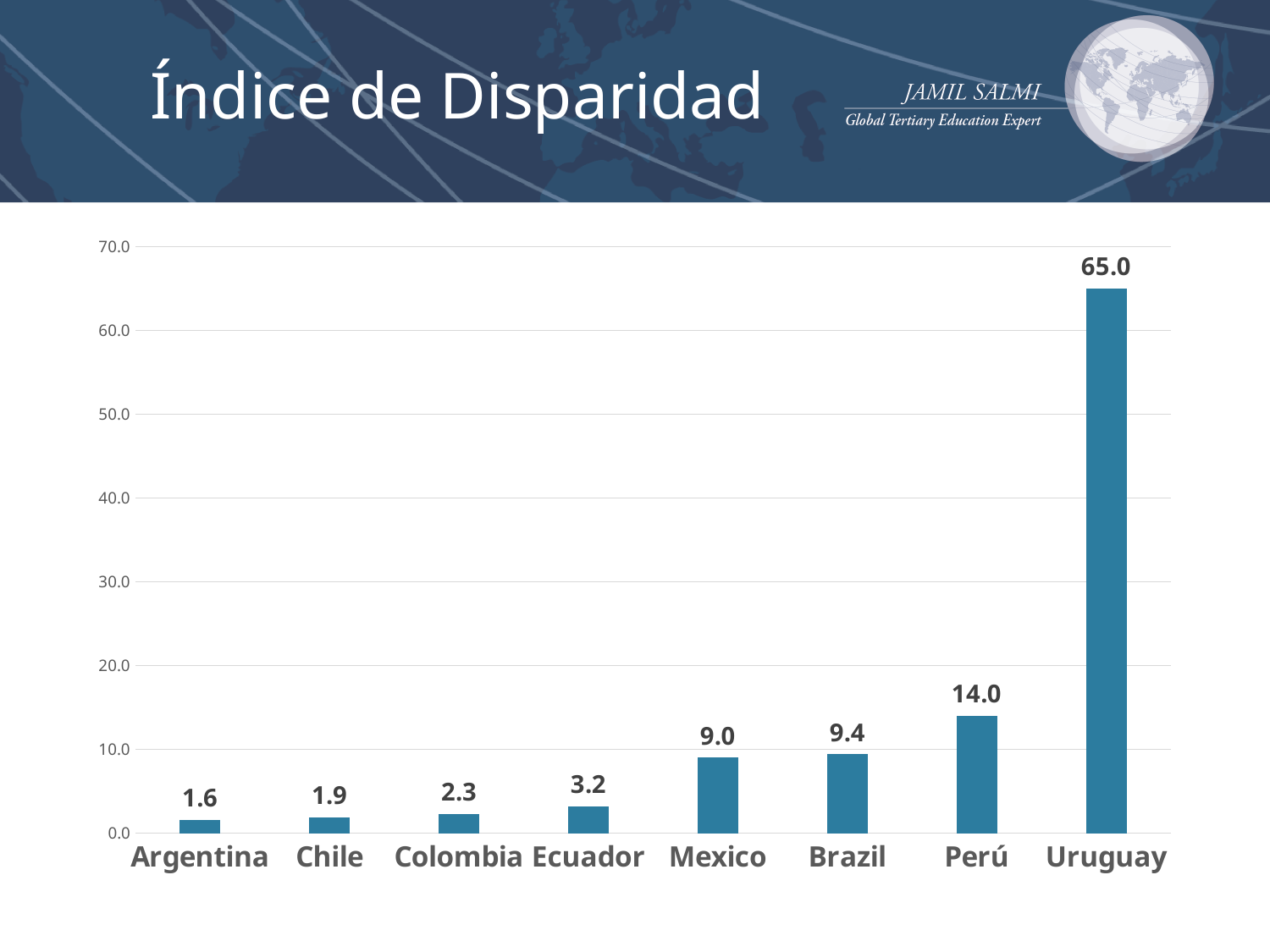
What is the value for Colombia? 2.3 Which country has the highest value? Uruguay What is the difference between the values for Uruguay and Perú? 51.0 Do the values rise or fall from Argentina to Uruguay along the x axis? rise What is the value for Uruguay? 65.0 Which country has the lowest value? Argentina Is the value for Perú greater or less than 10.0? greater How many countries are shown on the chart? 8 What is the value for Mexico? 9.0 Which is larger, the value for Ecuador or the value for Chile? Ecuador What is the difference between the values for Brazil and Mexico? 0.4 What kind of chart is shown on the slide? bar chart